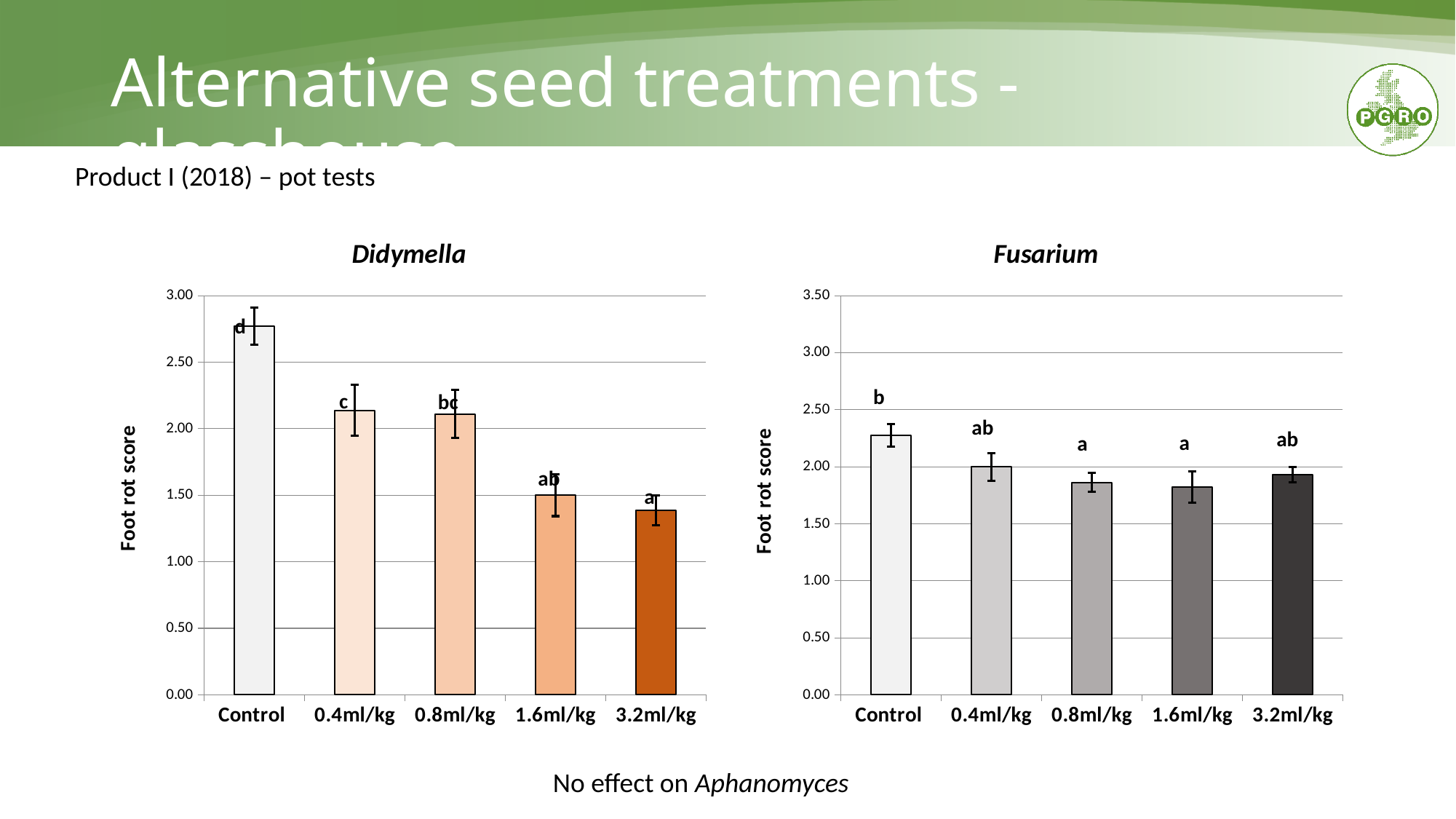
In the Didymella chart, which is larger, the value for Control or the value for 1.6ml/kg? Control What is the y-axis title of the Fusarium chart? Foot rot score What kind of chart is the Fusarium chart? bar chart In the Didymella chart, do the values generally rise or fall from Control to 3.2ml/kg? fall In the Didymella chart, is the value for Control greater or less than 2.50? greater In the Fusarium chart, is the value for 0.8ml/kg greater or less than 2.00? less In the Didymella chart, which category has the highest foot rot score? Control In the Fusarium chart, which category has the highest foot rot score? Control In the Fusarium chart, is the value for Control greater or less than 2.00? greater How many categories are shown on the x axis of the Didymella chart? 5 In the Fusarium chart, which is larger, the value for 0.4ml/kg or the value for 1.6ml/kg? 0.4ml/kg